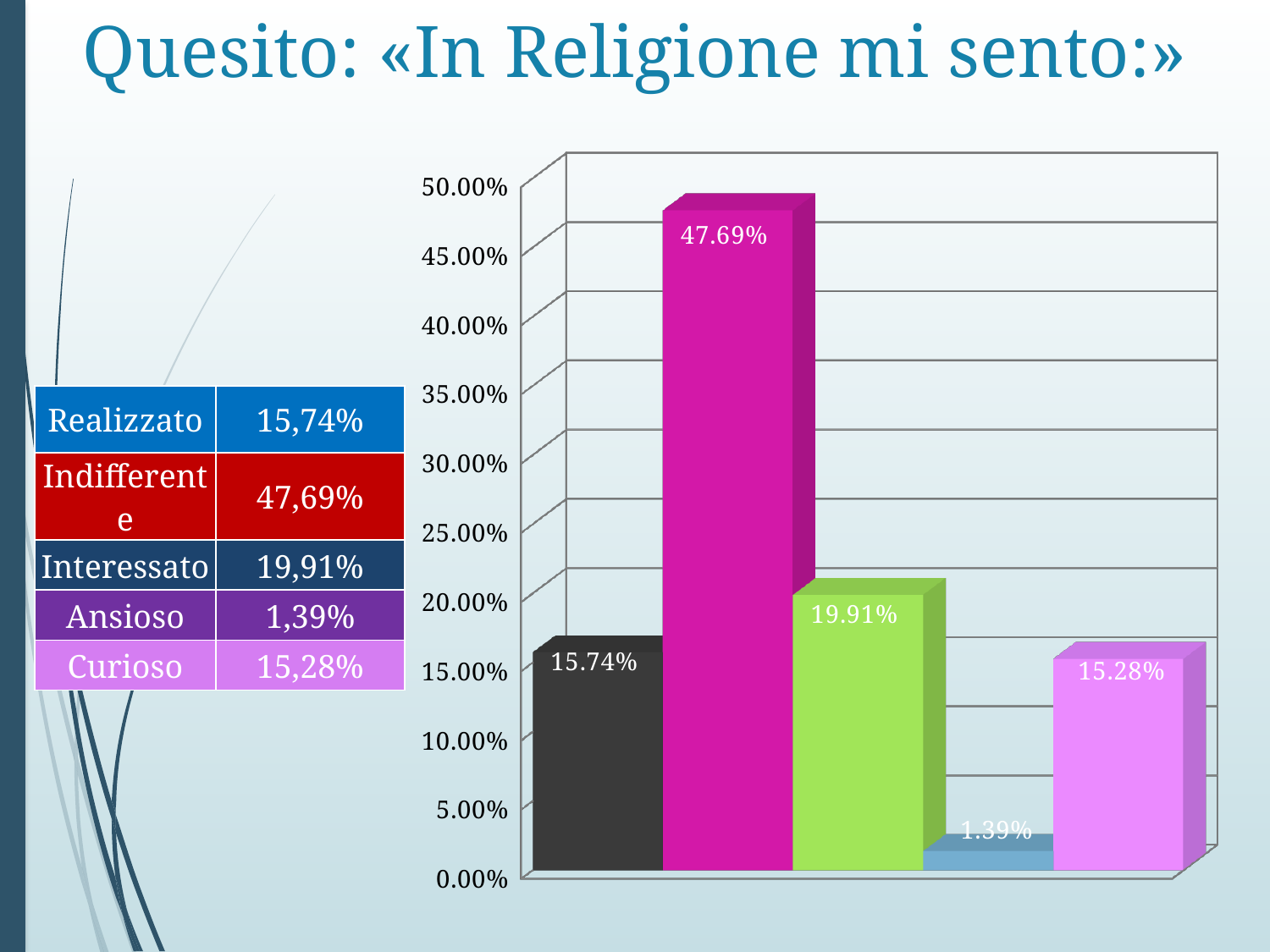
How many bars are plotted in the chart? 5 What is the difference between the values of the second bar (47.69%) and the third bar (19.91%) in the chart? 27.78% What is the data label on the third bar of the chart? 19.91% What kind of chart is shown on the slide? bar chart According to the table, which response has the highest percentage? Indifferente What is the value shown on the shortest bar in the chart? 1.39% What is the highest value shown on the chart's vertical axis? 50.00% What is the data label on the first (leftmost) bar of the chart? 15.74% What percentage does the table give for Curioso? 15,28% Which is larger in the chart: the first bar (15.74%) or the last bar (15.28%)? the first bar (15.74%) What is the value shown on the tallest bar in the chart? 47.69% According to the table, which response has the lowest percentage? Ansioso